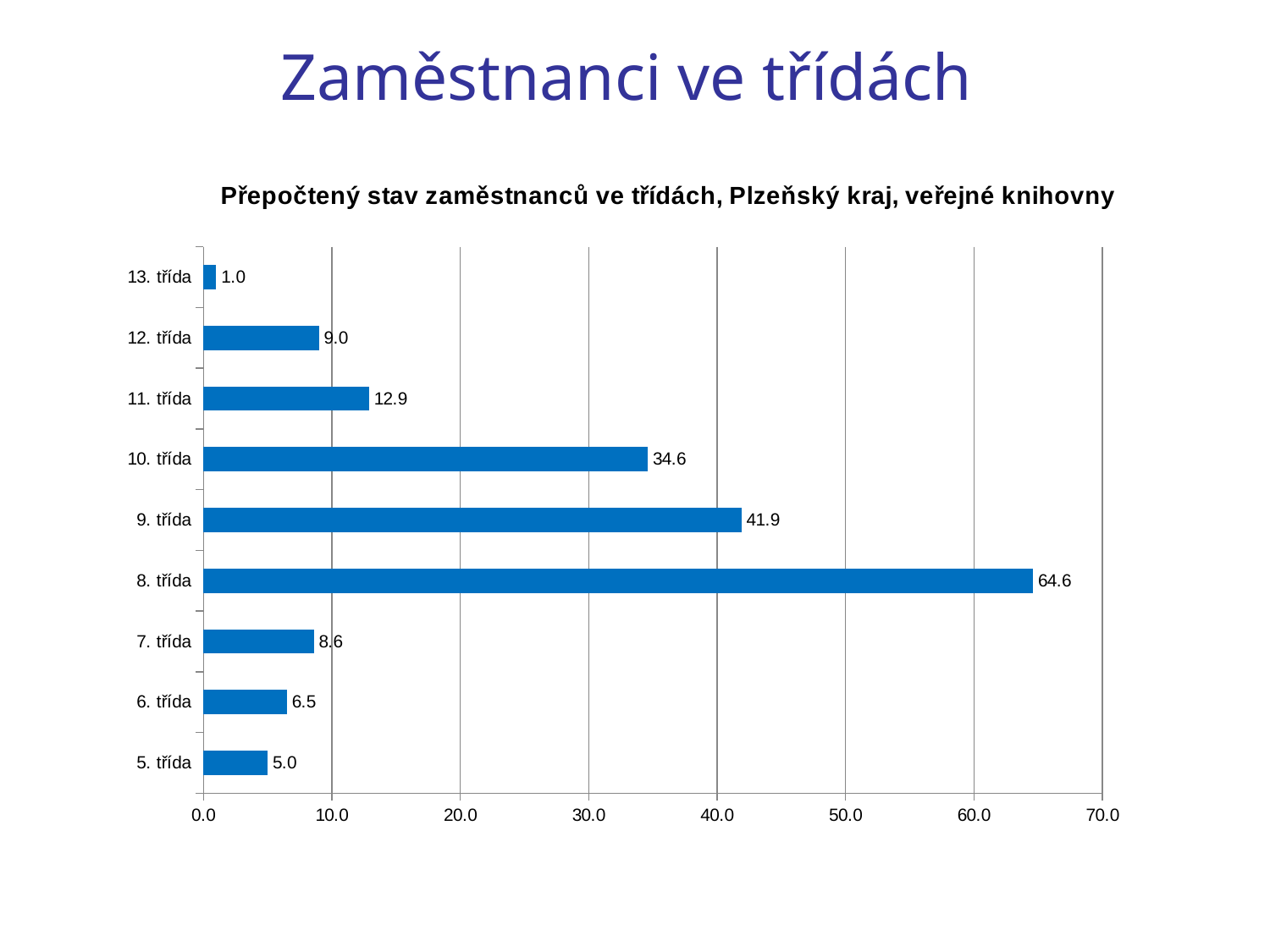
What is the value for 8. třída? 64.6 Which category has the highest value? 8. třída What is the maximum value shown on the horizontal axis? 70.0 How many categories are shown in the chart? 9 What is the difference between the values for 8. třída and 9. třída? 22.7 What is the value for 5. třída? 5.0 Is the value for 10. třída greater or less than 30.0? greater Which is larger, the value for 10. třída or the value for 9. třída? 9. třída Which category has the lowest value? 13. třída What is the title of the chart? Přepočtený stav zaměstnanců ve třídách, Plzeňský kraj, veřejné knihovny What is the value for 11. třída? 12.9 What kind of chart is shown on the slide? bar chart